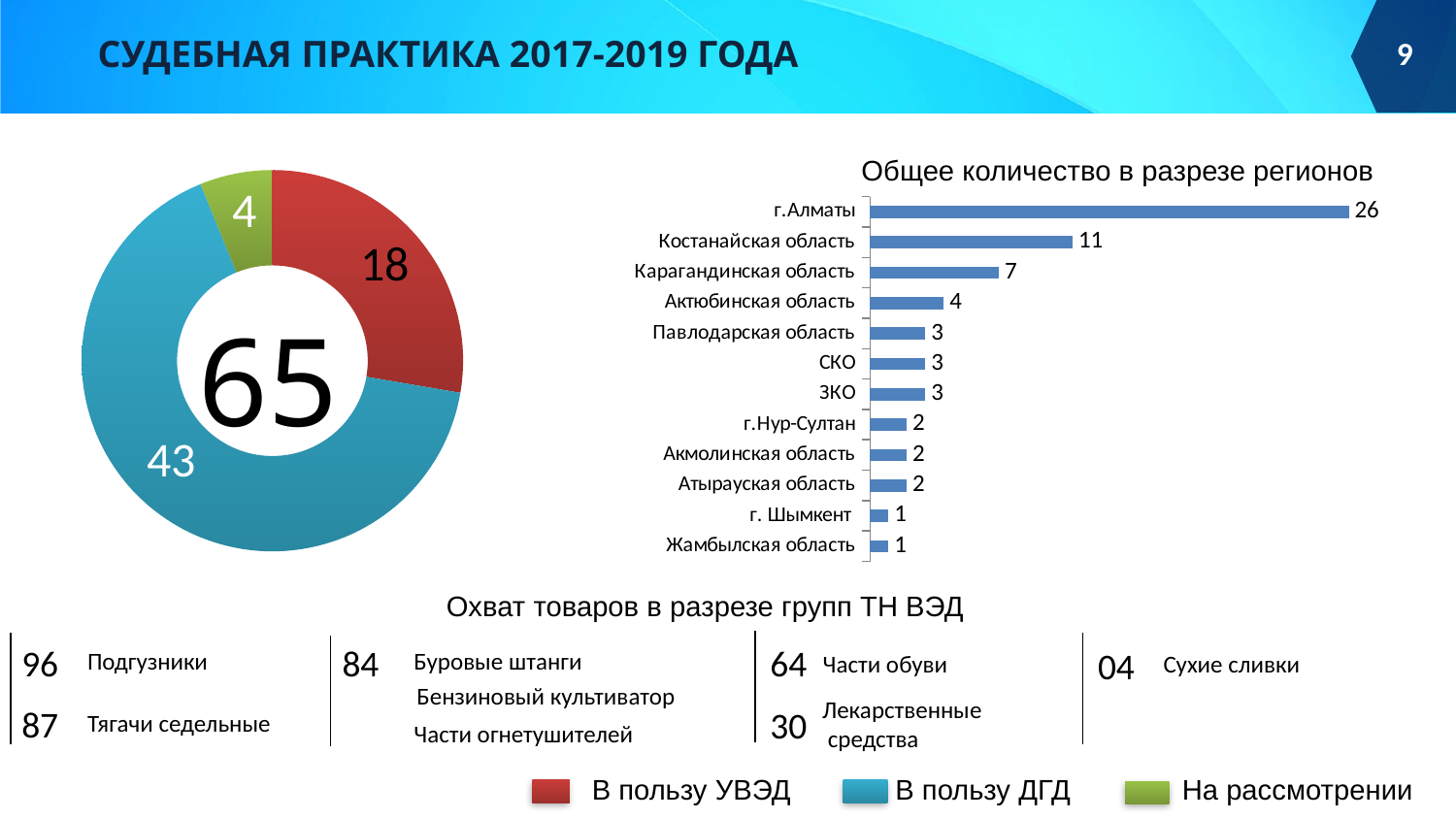
In the bar chart 'Общее количество в разрезе регионов', what is the difference between г.Алматы and Карагандинская область? 19 In the bar chart 'Общее количество в разрезе регионов', what is the value for г.Алматы? 26 In the donut chart on the left, which category has the smallest value? На рассмотрении In the bar chart 'Общее количество в разрезе регионов', which is larger: Актюбинская область or Павлодарская область? Актюбинская область In the bar chart 'Общее количество в разрезе регионов', what is the value for Костанайская область? 11 What number is shown in the centre of the donut chart on the left? 65 How many categories does the legend of the donut chart list? 3 How many regions are shown in the bar chart 'Общее количество в разрезе регионов'? 12 In the donut chart on the left, what is the value for 'В пользу УВЭД'? 18 What kind of chart is 'Общее количество в разрезе регионов'? bar chart In the bar chart 'Общее количество в разрезе регионов', which region has the highest value? г.Алматы In the donut chart on the left, what is the value for 'В пользу ДГД'? 43